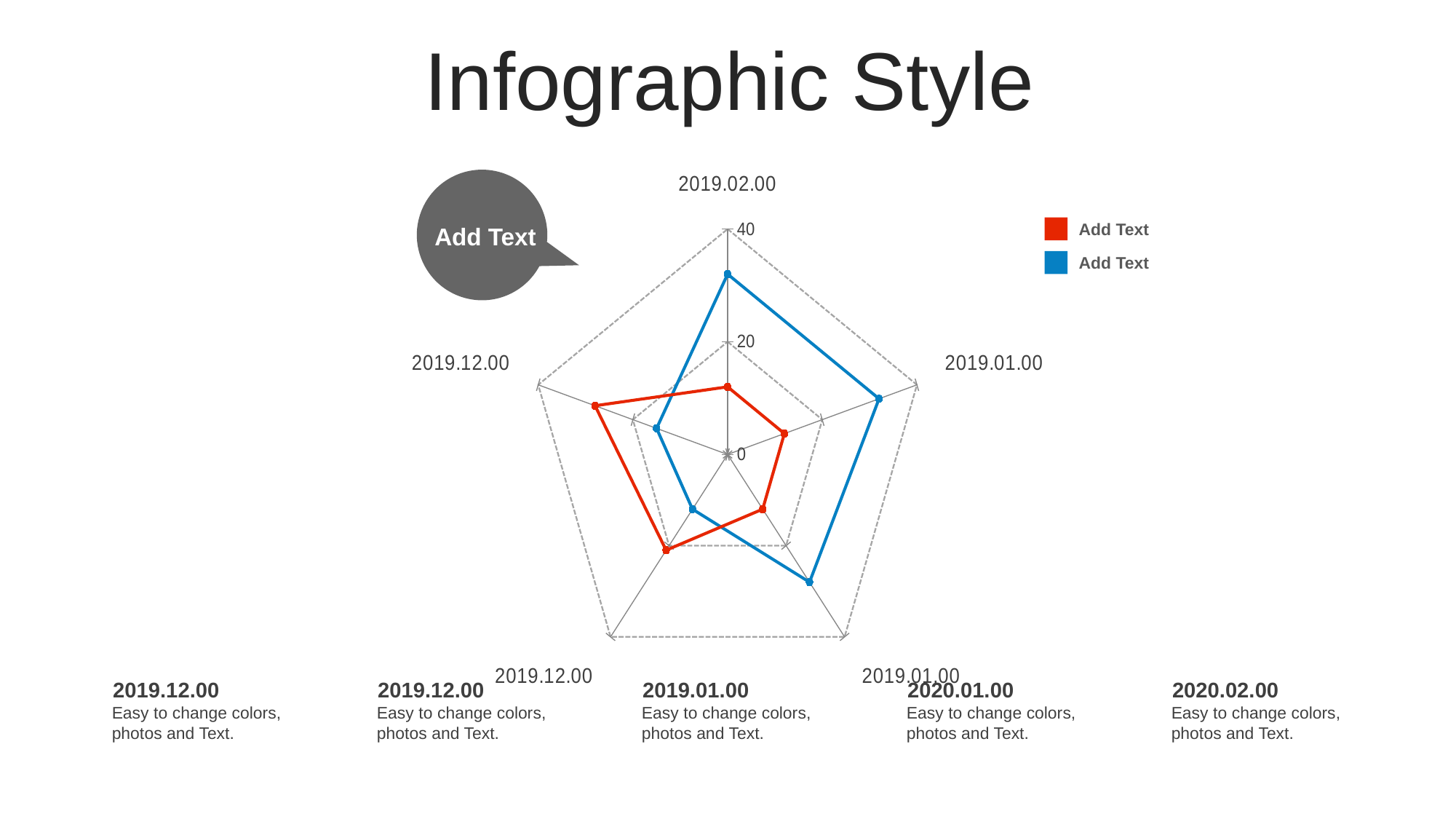
On the 2019.02.00 axis, which series has the larger value, the red one or the blue one? Blue What kind of chart is shown on the slide? Radar chart How many axes (categories) does the radar chart have? 5 How many series does the chart's legend list? 2 On which axis does the red series reach its highest value? 2019.12.00 What text is used for both entries in the chart's legend? Add Text What is the highest value shown on the chart's radial axis? 40 Is the value of the red series on the 2019.02.00 axis greater or less than 20? less Is the value of the blue series on the 2019.02.00 axis greater or less than 40? less Is the value of the blue series on the 2019.02.00 axis greater or less than 20? greater On the right-hand 2019.01.00 axis, which series has the larger value, the red one or the blue one? Blue